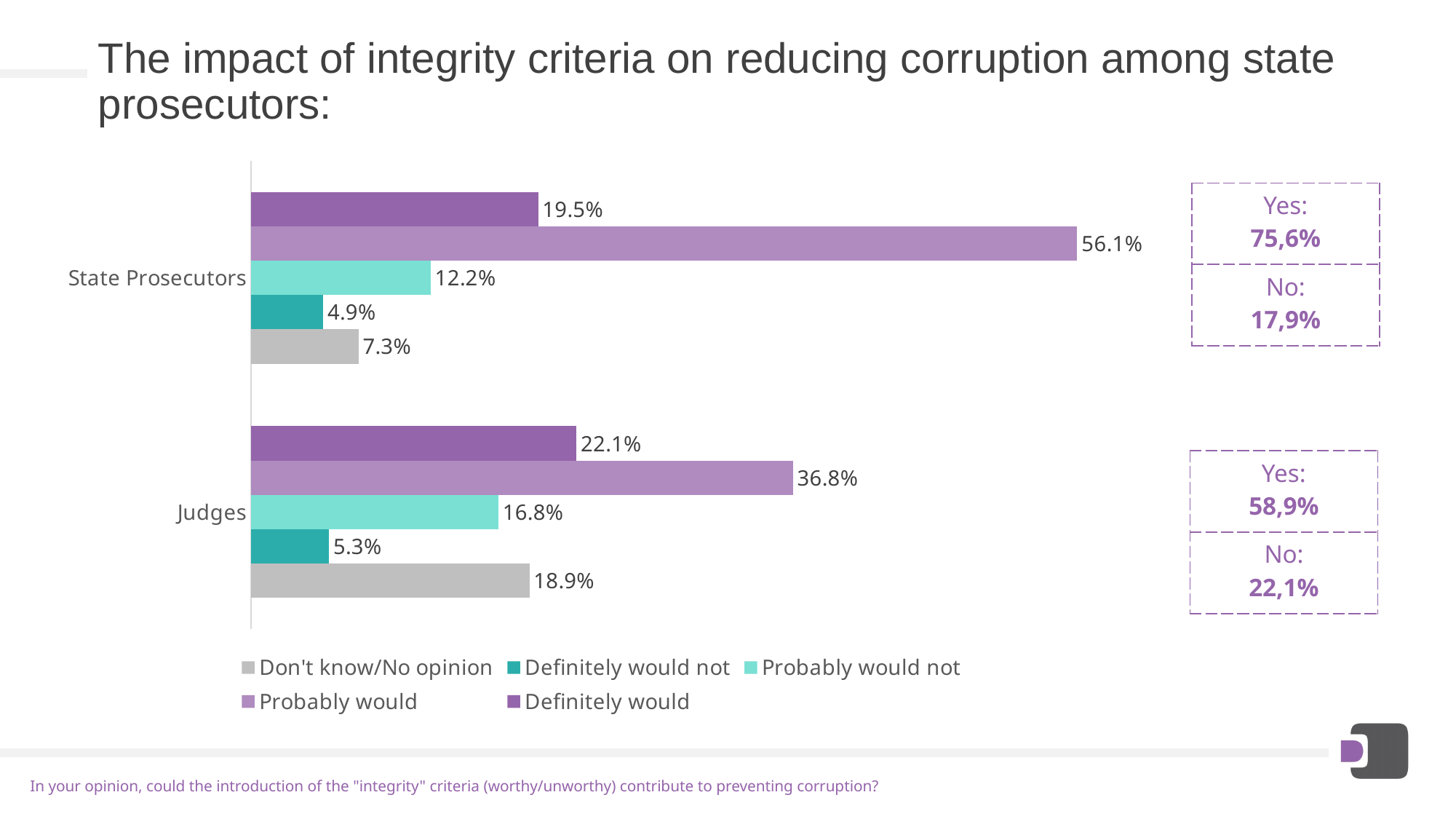
What is the value for 'Definitely would' for Judges? 22.1% What is the value for 'Definitely would not' for State Prosecutors? 4.9% What colour are the 'Don't know/No opinion' bars? Grey What is the difference between the 'Probably would' values for State Prosecutors and Judges? 19.3% Which response has the lowest value for Judges? Definitely would not How many series does the legend list? 5 What kind of chart is shown on the slide? Bar chart How many categories are shown on the chart? 2 What is the value for 'Don't know/No opinion' for Judges? 18.9% What is the value for 'Probably would' for State Prosecutors? 56.1% Which response has the highest value for State Prosecutors? Probably would Which is larger: 'Probably would not' for Judges or 'Probably would not' for State Prosecutors? Judges